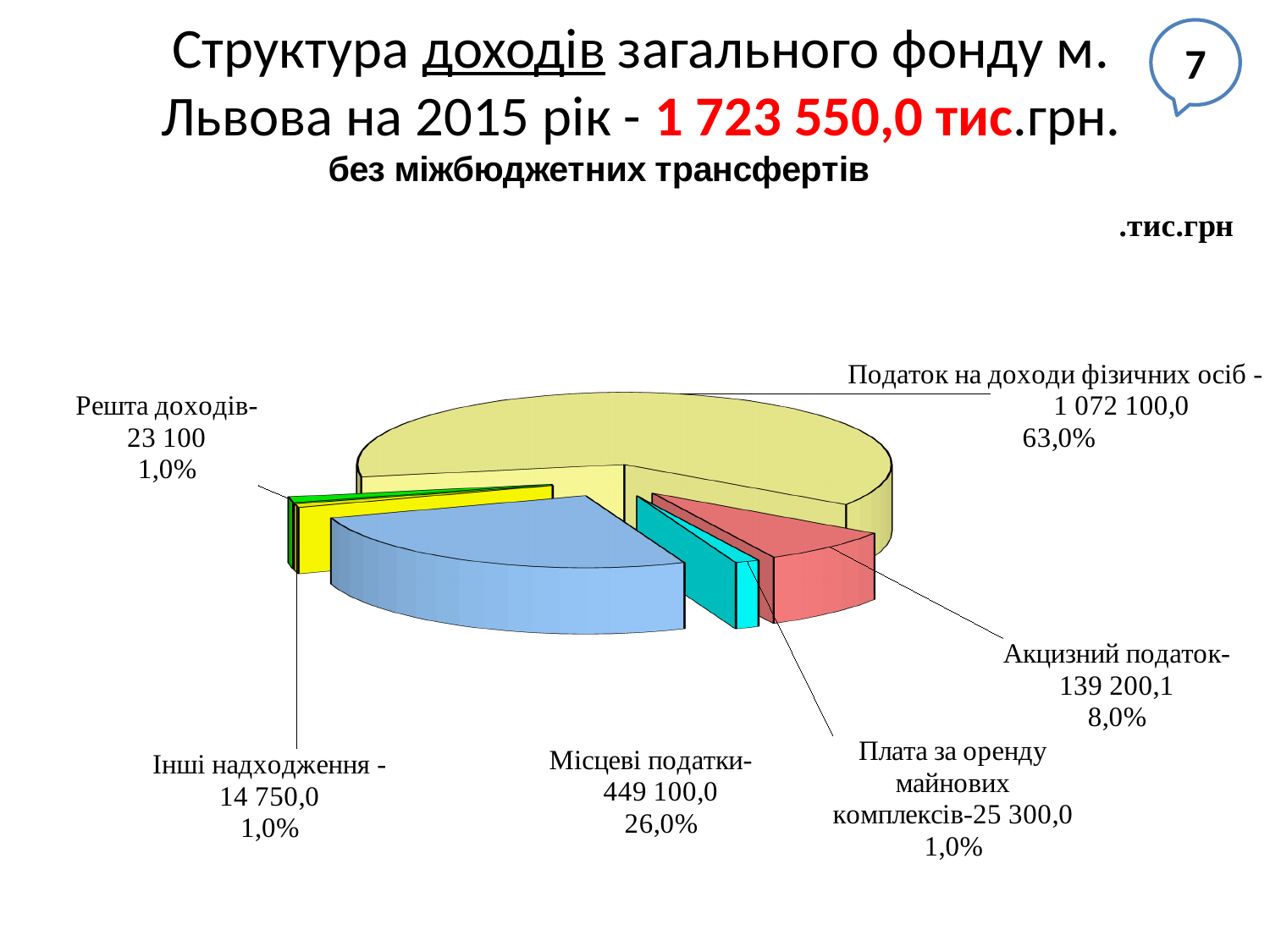
What kind of chart is shown on the slide? Pie chart What is the value shown for Податок на доходи фізичних осіб? 1 072 100,0 What is the value shown for Плата за оренду майнових комплексів? 25 300,0 What share of the pie does Податок на доходи фізичних осіб represent? 63,0% What is the difference between the values for Місцеві податки and Акцизний податок? 309 899,9 What is the value shown for Місцеві податки? 449 100,0 What percentage is shown for Місцеві податки? 26,0% What is the value shown for Акцизний податок? 139 200,1 Which is larger, the value for Решта доходів or the value for Інші надходження? Решта доходів Which category has the smallest value in the pie chart? Інші надходження How many slices does the pie chart have? 6 Which category has the largest slice of the pie? Податок на доходи фізичних осіб